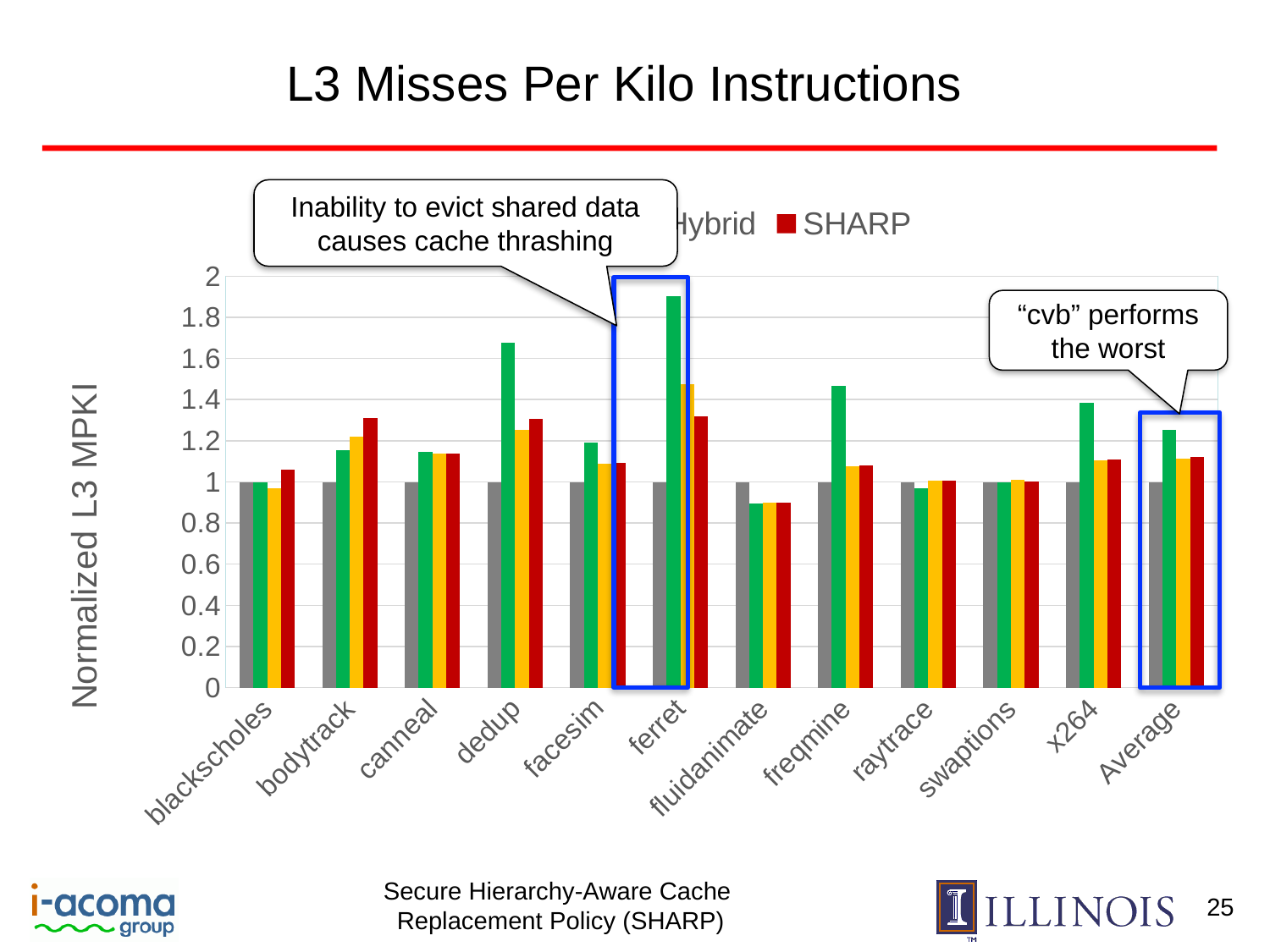
Is the SHARP value for fluidanimate greater or less than 1? less Which is larger, the Hybrid value for ferret or the Hybrid value for canneal? ferret What kind of chart is shown on the slide? bar chart Is the SHARP value for Average greater or less than 1? greater Which category has the lowest SHARP value? fluidanimate Is the SHARP value for bodytrack greater or less than 1.2? greater What is the title of the chart? L3 Misses Per Kilo Instructions What is the label on the vertical axis of the chart? Normalized L3 MPKI Which is larger, the SHARP value for dedup or the SHARP value for fluidanimate? dedup How many categories are shown along the x axis of the chart? 12